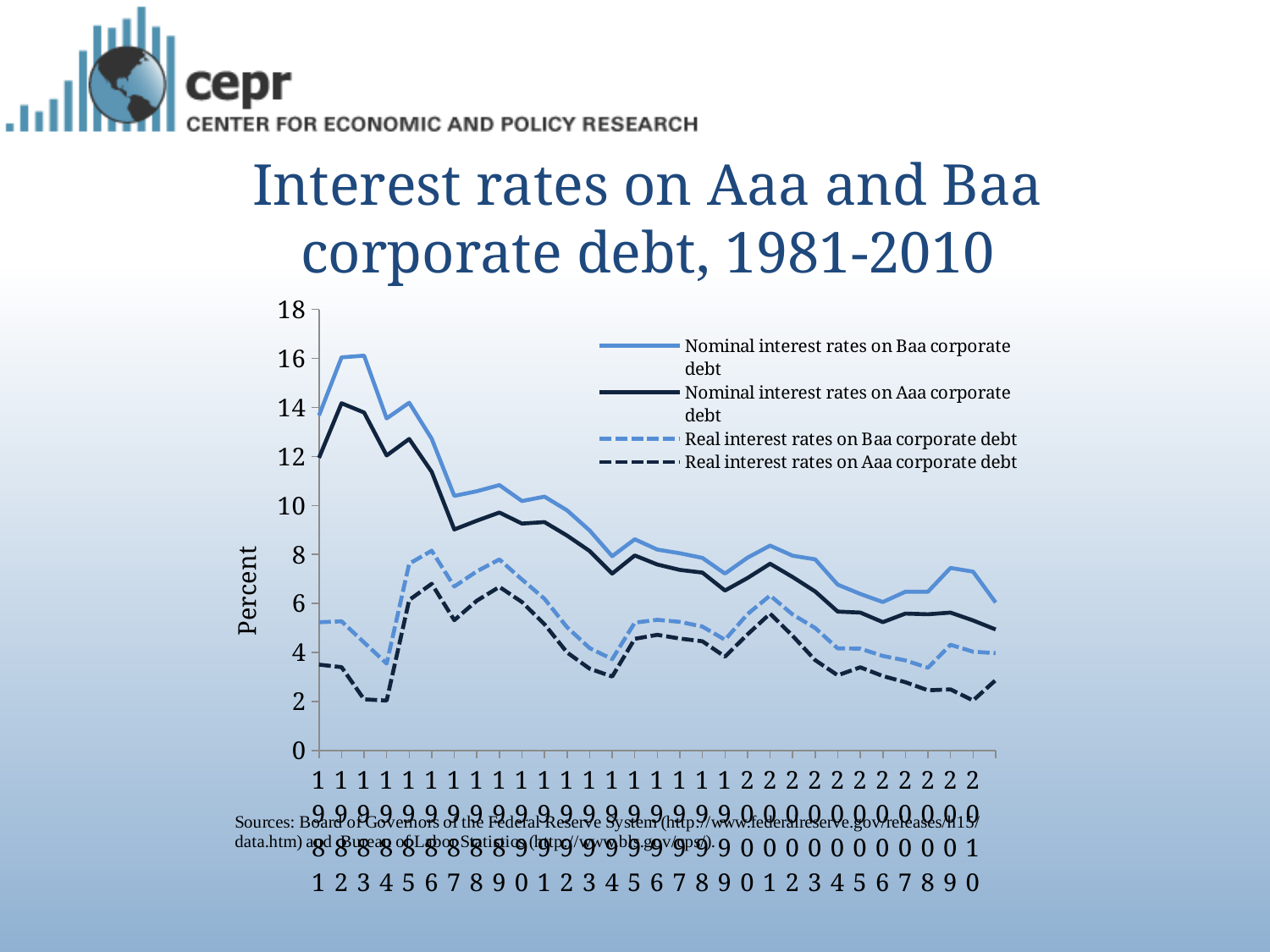
In 2000, which is larger: real interest rates on Baa corporate debt or real interest rates on Aaa corporate debt? Real interest rates on Baa corporate debt How many series does the legend list? 4 What is the label on the vertical axis? Percent What is the title of the chart? Interest rates on Aaa and Baa corporate debt, 1981-2010 In 1982, which is larger: nominal interest rates on Baa corporate debt or nominal interest rates on Aaa corporate debt? Nominal interest rates on Baa corporate debt Is the value for real interest rates on Baa corporate debt in 1986 greater or less than 6? greater How many years are plotted along the x axis? 30 Is the value for nominal interest rates on Aaa corporate debt in 2010 greater or less than 6? less What kind of chart is shown on the slide? line chart Is the value for real interest rates on Aaa corporate debt in 1984 greater or less than 4? less Overall, do nominal interest rates on Baa corporate debt rise or fall from 1982 to 2010? fall